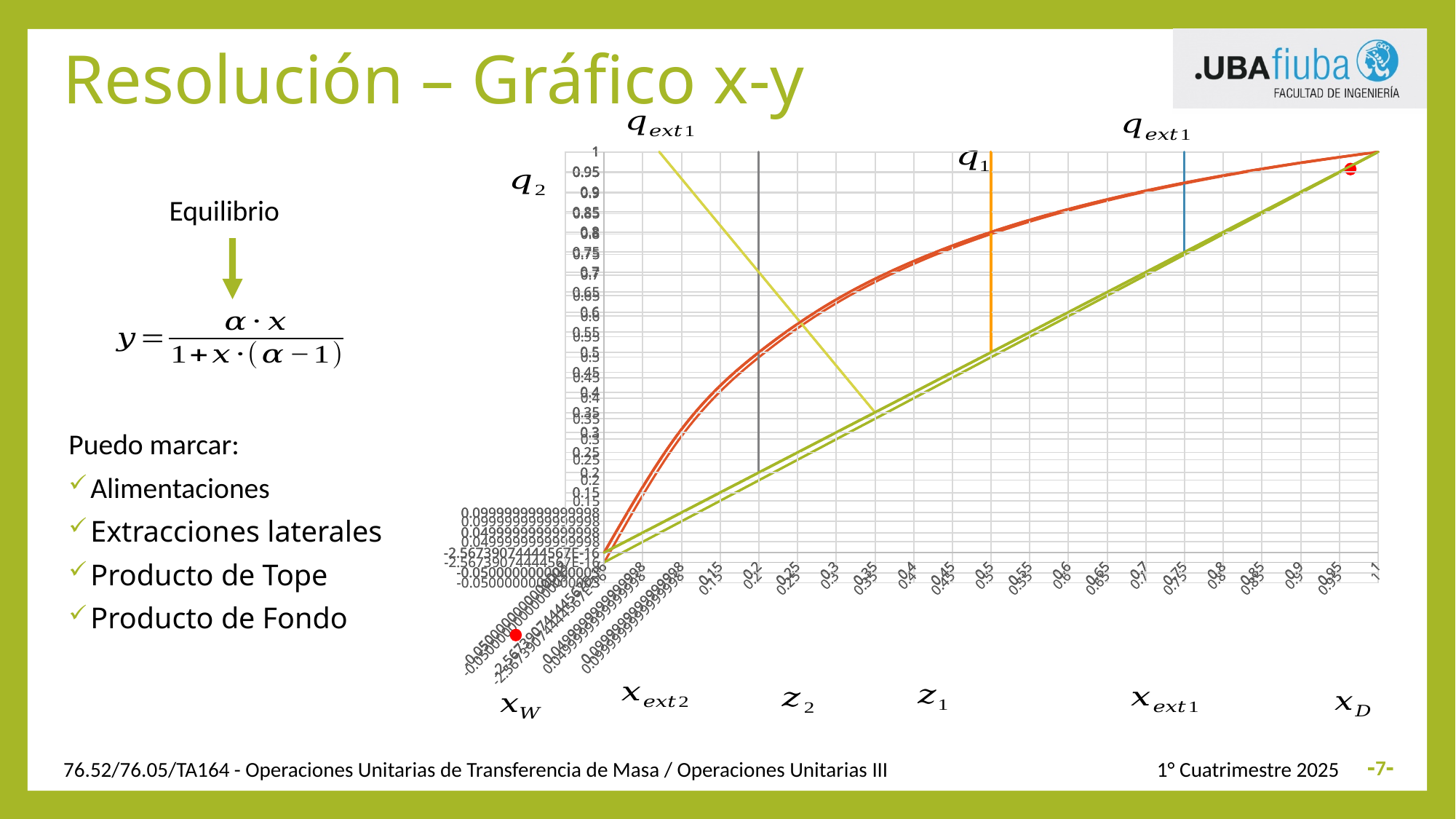
What is the maximum value shown on the y axis of the chart? 1 At which x value does the vertical gray line stand? 0.2 At x = 0.5, is the value of the orange equilibrium curve greater or less than 0.7? greater What colour is the curved equilibrium line in the chart? orange At which x value does the vertical blue line labelled q_ext1 stand? 0.75 How many vertical q-lines are drawn inside the chart? 3 At x = 0.5, which line is higher: the orange equilibrium curve or the green diagonal line? the orange equilibrium curve At x = 0.2, is the value of the orange equilibrium curve greater or less than 0.4? greater What kind of chart is shown on the slide? line chart What is the title of the slide containing the chart? Resolución – Gráfico x-y At which x value does the vertical orange line labelled q1 stand? 0.5 Does the orange equilibrium curve rise or fall as x increases? rise